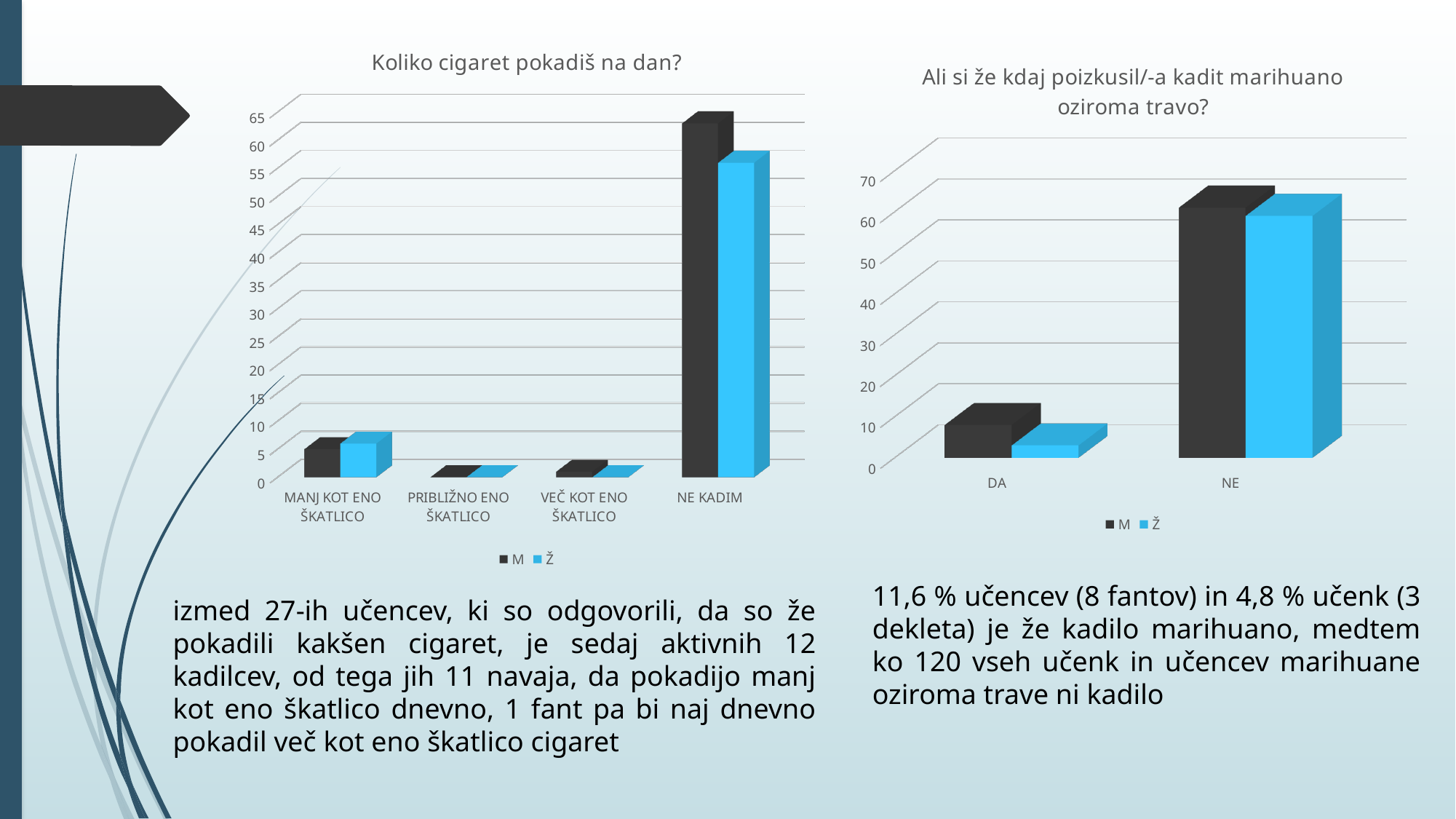
In the chart titled "Ali si že kdaj poizkusil/-a kadit marihuano oziroma travo?", for DA, which series has the larger value, M or Ž? M In the chart titled "Koliko cigaret pokadiš na dan?", how many categories are shown on the x axis? 4 In the chart titled "Koliko cigaret pokadiš na dan?", for NE KADIM, which series has the larger value, M or Ž? M What kind of chart is the chart titled "Koliko cigaret pokadiš na dan?"? bar chart In the chart titled "Ali si že kdaj poizkusil/-a kadit marihuano oziroma travo?", what are the two legend entries? M and Ž In the chart titled "Koliko cigaret pokadiš na dan?", is the value for MANJ KOT ENO ŠKATLICO in series M greater or less than 10? less In the chart titled "Koliko cigaret pokadiš na dan?", which category has the highest value for series M? NE KADIM In the chart titled "Ali si že kdaj poizkusil/-a kadit marihuano oziroma travo?", is the value for NE in series M greater or less than 50? greater In the chart titled "Ali si že kdaj poizkusil/-a kadit marihuano oziroma travo?", how many categories are shown on the x axis? 2 In the chart titled "Ali si že kdaj poizkusil/-a kadit marihuano oziroma travo?", which category has the highest value for series Ž? NE In the chart titled "Koliko cigaret pokadiš na dan?", is the value for NE KADIM in series M greater or less than 50? greater In the chart titled "Koliko cigaret pokadiš na dan?", how many series does the legend list? 2